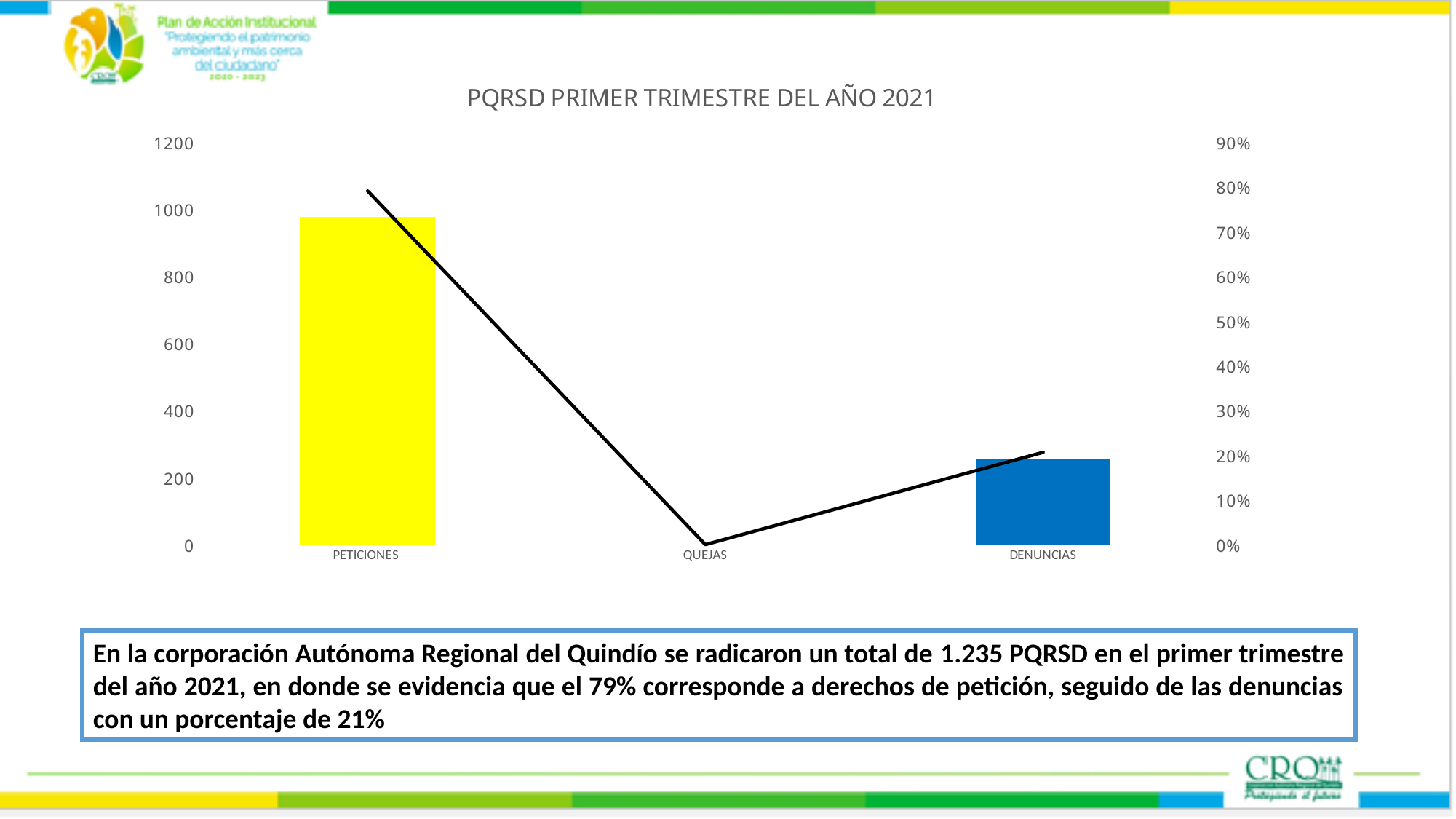
What is the highest value shown on the left vertical axis? 1200 Is the bar value for PETICIONES greater or less than 800? greater Which category has the lowest bar in the chart? QUEJAS What is the title of the chart? PQRSD PRIMER TRIMESTRE DEL AÑO 2021 Does the line fall or rise from PETICIONES to QUEJAS? falls What colour is the PETICIONES bar? Yellow Which category has the tallest bar in the chart? PETICIONES Is the bar value for DENUNCIAS greater or less than 400? less How many categories are shown on the x axis of the chart? 3 Is the bar value for DENUNCIAS greater or less than 200? greater Which bar is taller, PETICIONES or DENUNCIAS? PETICIONES